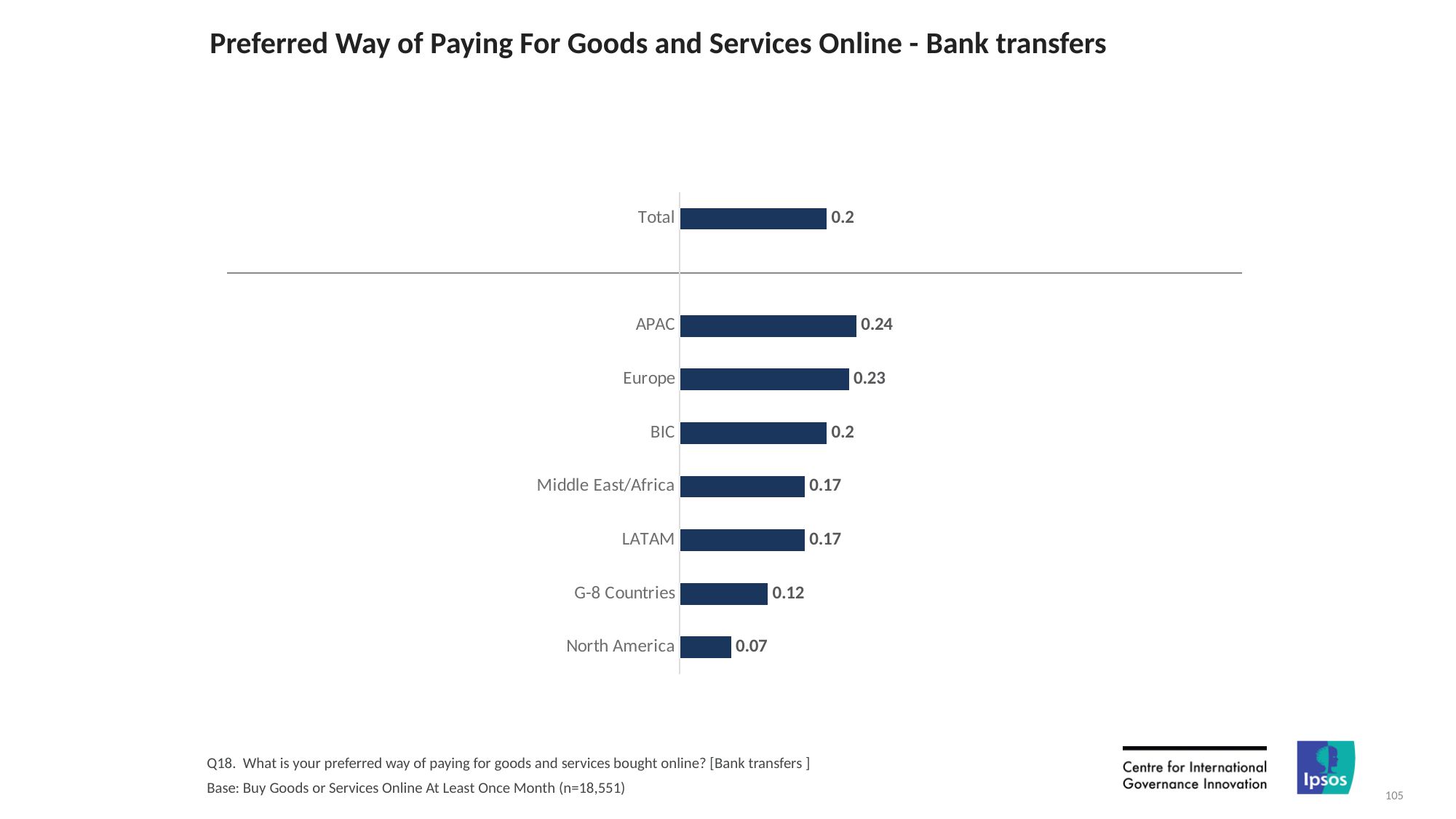
What is the value for G-8 Countries? 0.12 What is the value for Total? 0.2 What is the title of the chart? Preferred Way of Paying For Goods and Services Online - Bank transfers What is the value for North America? 0.07 Which region has the lowest value? North America Which region has the highest value? APAC Which is larger, the value for BIC or the value for G-8 Countries? BIC What is the difference between the values for APAC and North America? 0.17 How many bars are shown in the chart, including Total? 8 What is the difference between the values for Europe and G-8 Countries? 0.11 What is the value for APAC? 0.24 What kind of chart is shown on the slide? Bar chart